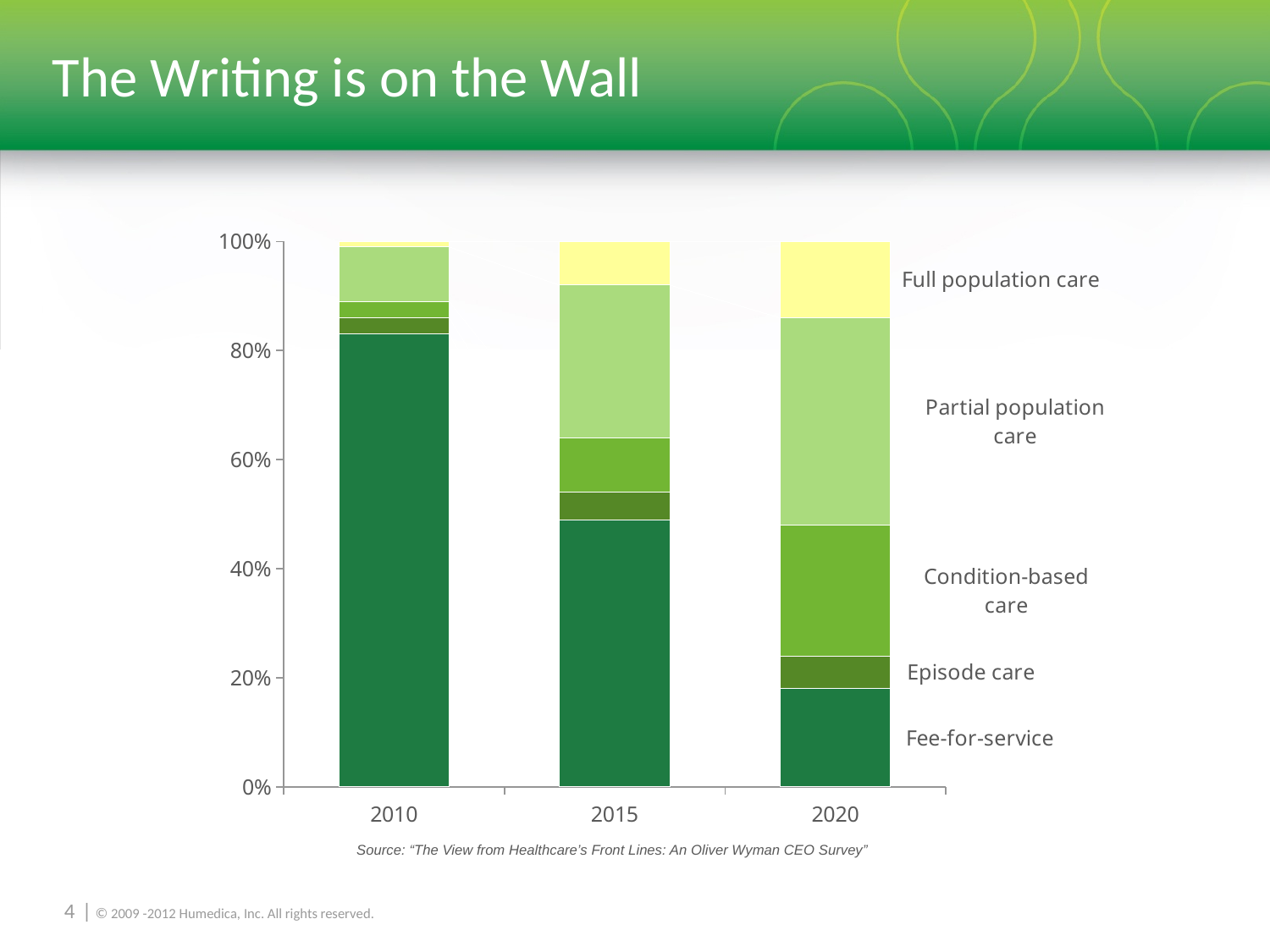
How many years are shown on the x axis of the chart? 3 What is the title of the slide containing the chart? The Writing is on the Wall Is the Fee-for-service share in 2010 greater or less than 80%? greater Is the Fee-for-service share in 2020 greater or less than 20%? less What kind of chart is shown on the slide? Stacked bar chart How many care categories (series) are labelled on the chart? 5 Is the Fee-for-service share larger in 2010 or in 2020? 2010 Which year has the smallest Fee-for-service share? 2020 Is the Fee-for-service share in 2015 greater or less than 60%? less What is the total of the stacked bar for 2020? 100% Which year has the largest Fee-for-service share? 2010 Does the Fee-for-service share rise or fall from 2010 to 2020? Fall